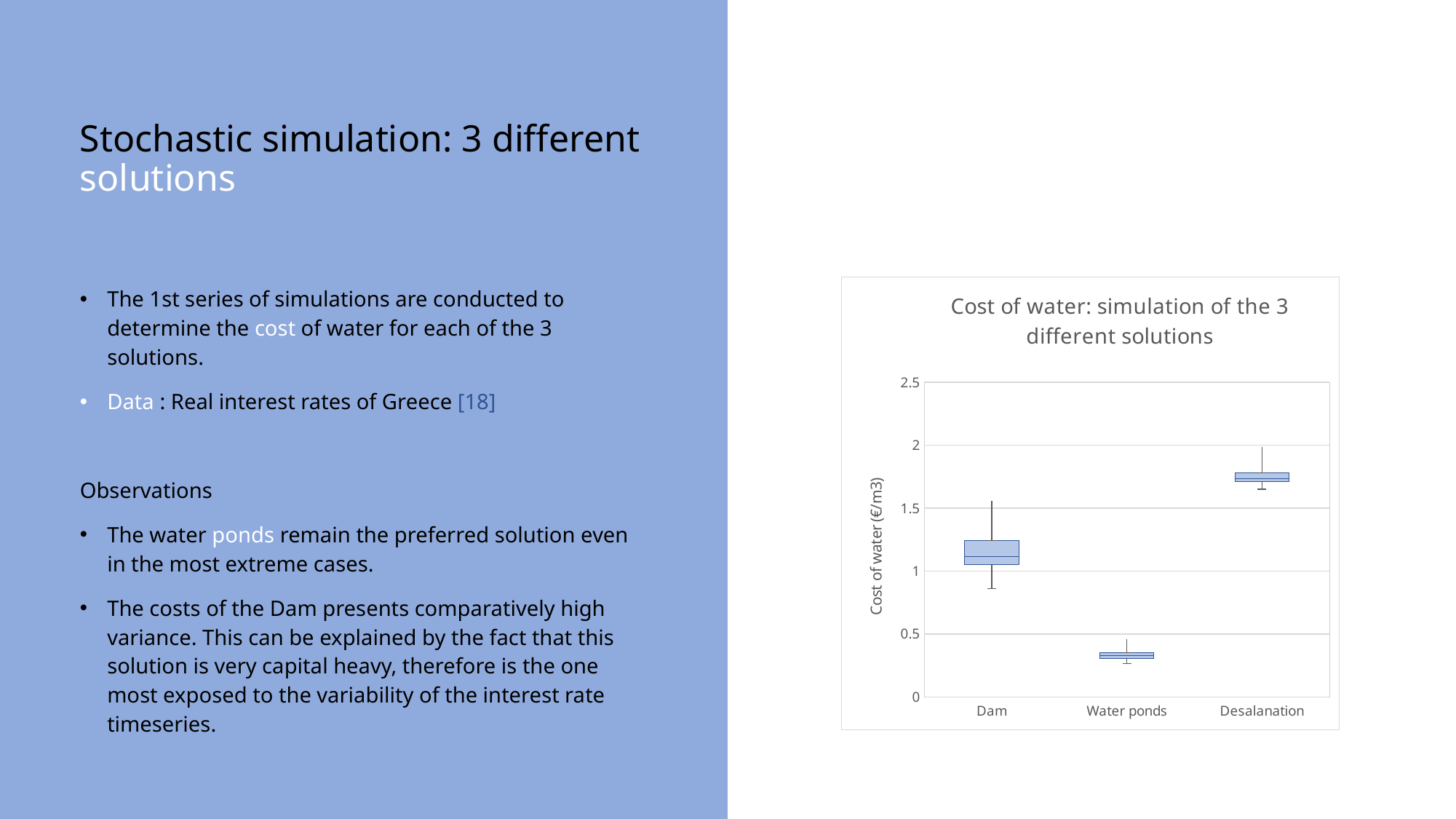
Is the median cost of water for Dam greater or less than 1.5? less What is the title of the chart? Cost of water: simulation of the 3 different solutions Which has a lower median cost of water, Water ponds or Dam? Water ponds Which has a higher median cost of water, Dam or Desalanation? Desalanation Which solution shows the widest spread (largest box and whiskers) in the chart? Dam Which solution has the lowest median cost of water in the chart? Water ponds Is the median cost of water for Water ponds greater or less than 0.5? less Is the median cost of water for Desalanation greater or less than 1.5? greater Which solution has the highest median cost of water in the chart? Desalanation How many solutions (categories) are plotted on the x axis of the chart? 3 What is the label of the y axis of the chart? Cost of water (€/m3) What kind of chart is shown on the slide? Box plot